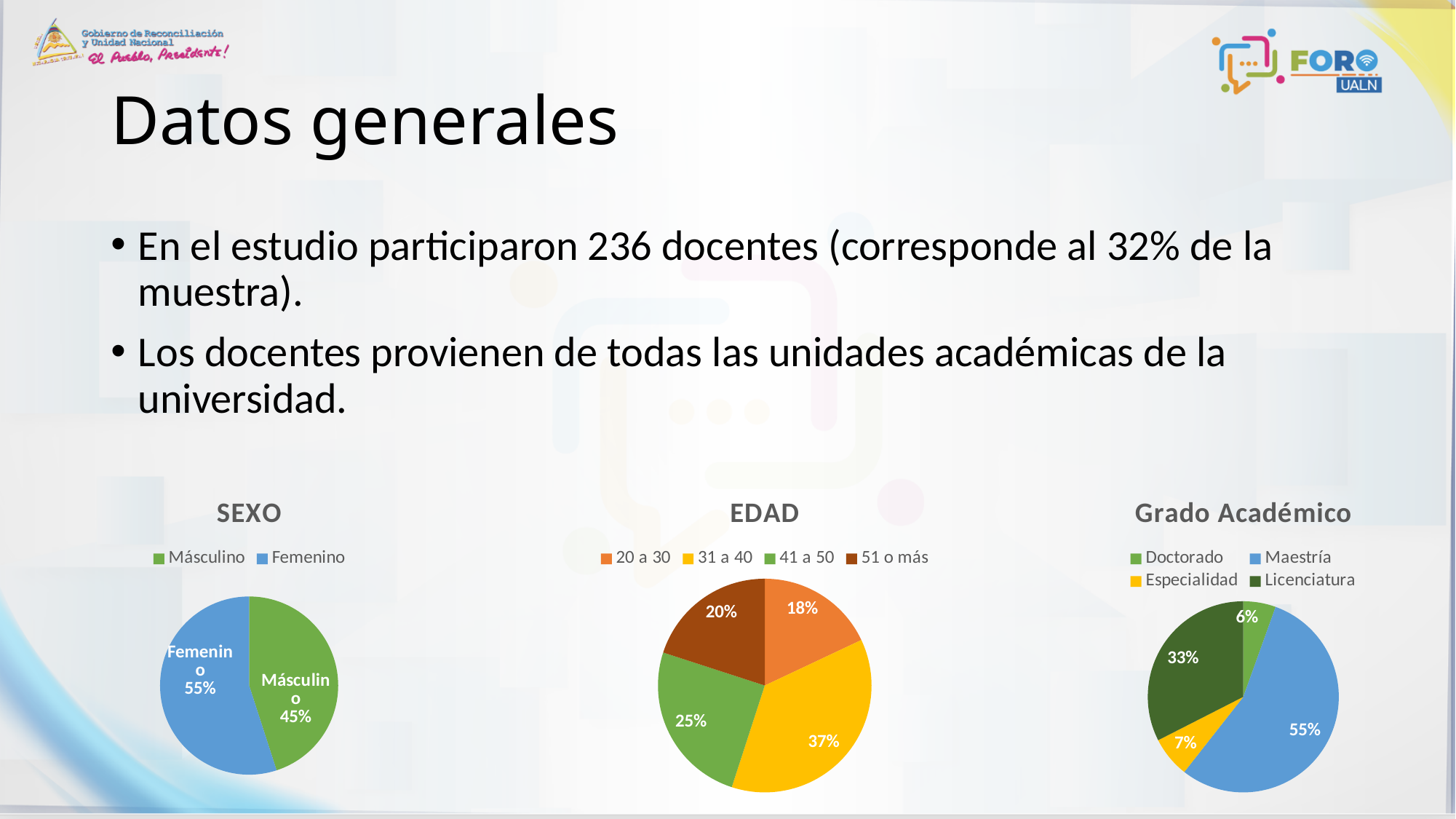
In the Grado Académico chart, what share is Maestría? 55% In the SEXO chart, what share is Femenino? 55% In the EDAD chart, what share is the 20 a 30 group? 18% In the EDAD chart, which age group has the largest share? 31 a 40 What kind of chart is the Grado Académico chart? Pie chart In the Grado Académico chart, which is larger, Licenciatura or Especialidad? Licenciatura In the EDAD chart, which age group has the smallest share? 20 a 30 In the Grado Académico chart, which category has the smallest share? Doctorado How many categories does the EDAD chart's legend list? 4 In the EDAD chart, what is the difference between the 41 a 50 share and the 51 o más share? 5%